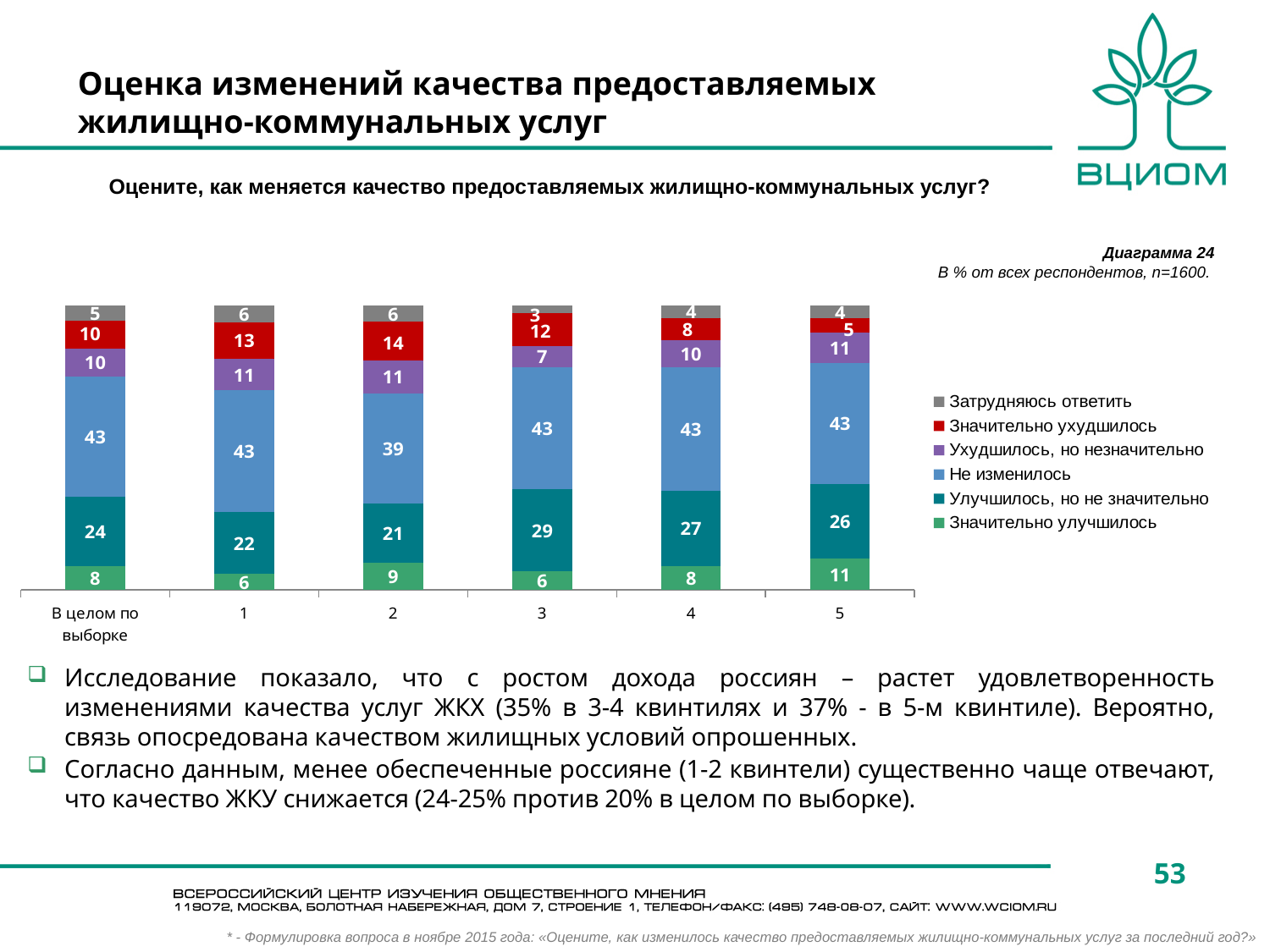
What is the value of "Улучшилось, но не значительно" for "В целом по выборке"? 24 Which category has the highest value for "Улучшилось, но не значительно"? 3 What is the total of the stacked bar for category 1? 101 Which is larger: "Ухудшилось, но незначительно" for category 3 or for category 4? category 4 How many series does the legend list? 6 What is the value of "Значительно улучшилось" for category 5? 11 What kind of chart is shown on the slide? stacked bar chart What is the value of "Не изменилось" for category 2? 39 How many categories are shown along the x axis? 6 Which category has the lowest value for "Значительно ухудшилось"? 5 What is the difference between the "Значительно ухудшилось" values for category 2 and category 5? 9 What is the value of "Значительно ухудшилось" for category 1? 13